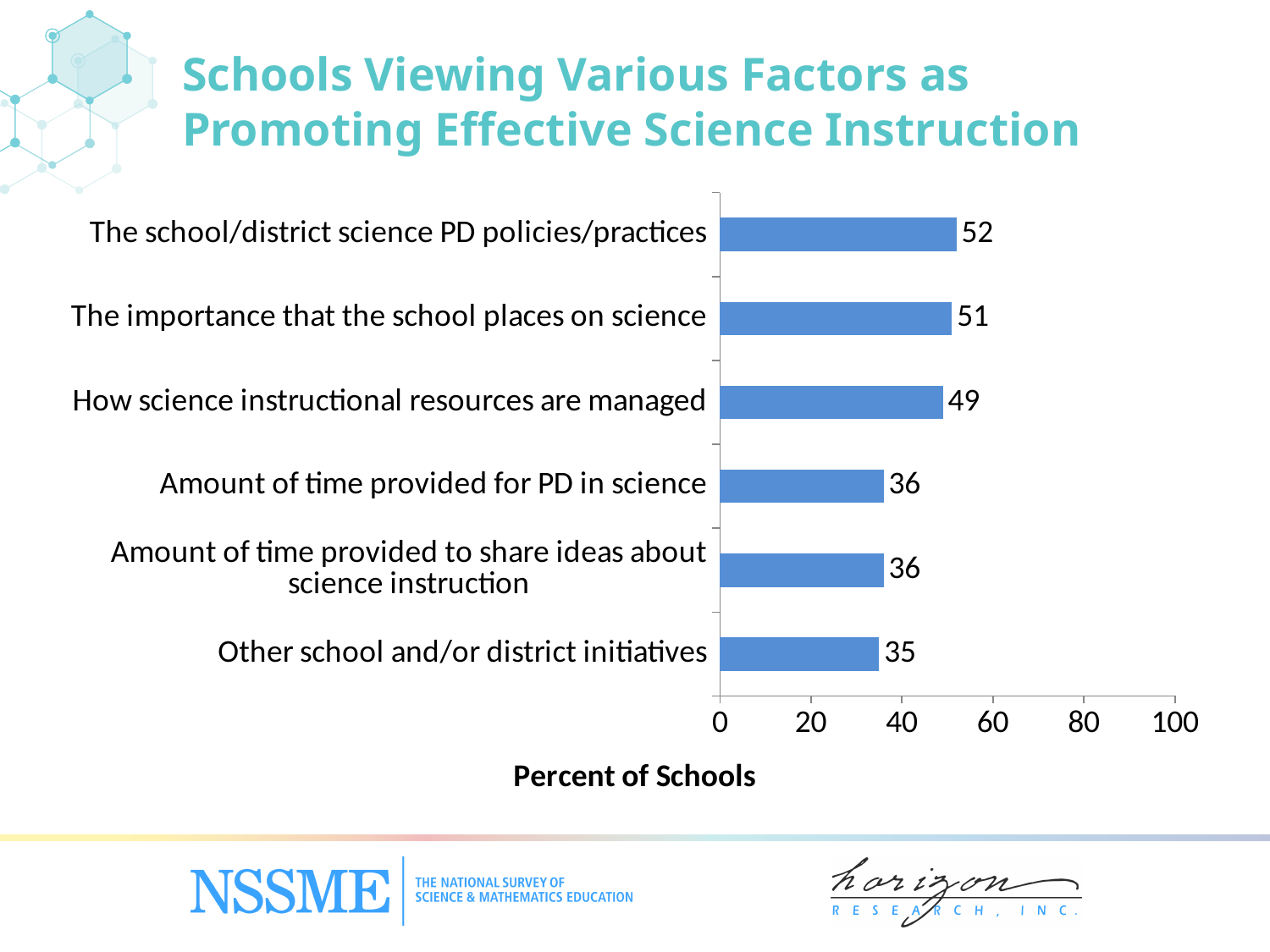
Which is larger: the value for 'The importance that the school places on science' or 'How science instructional resources are managed'? The importance that the school places on science What is the label of the horizontal axis? Percent of Schools Which factor has the highest percent of schools? The school/district science PD policies/practices What is the value for 'How science instructional resources are managed'? 49 Which factor has the lowest percent of schools? Other school and/or district initiatives What is the maximum value shown on the horizontal axis? 100 How many factors are shown in the chart? 6 Is the value for 'Amount of time provided to share ideas about science instruction' greater or less than 40? less What kind of chart is shown on the slide? Bar chart What percent of schools view the school/district science PD policies/practices as promoting effective science instruction? 52 What is the difference between the values for 'The school/district science PD policies/practices' and 'Amount of time provided for PD in science'? 16 What is the value for 'Other school and/or district initiatives'? 35